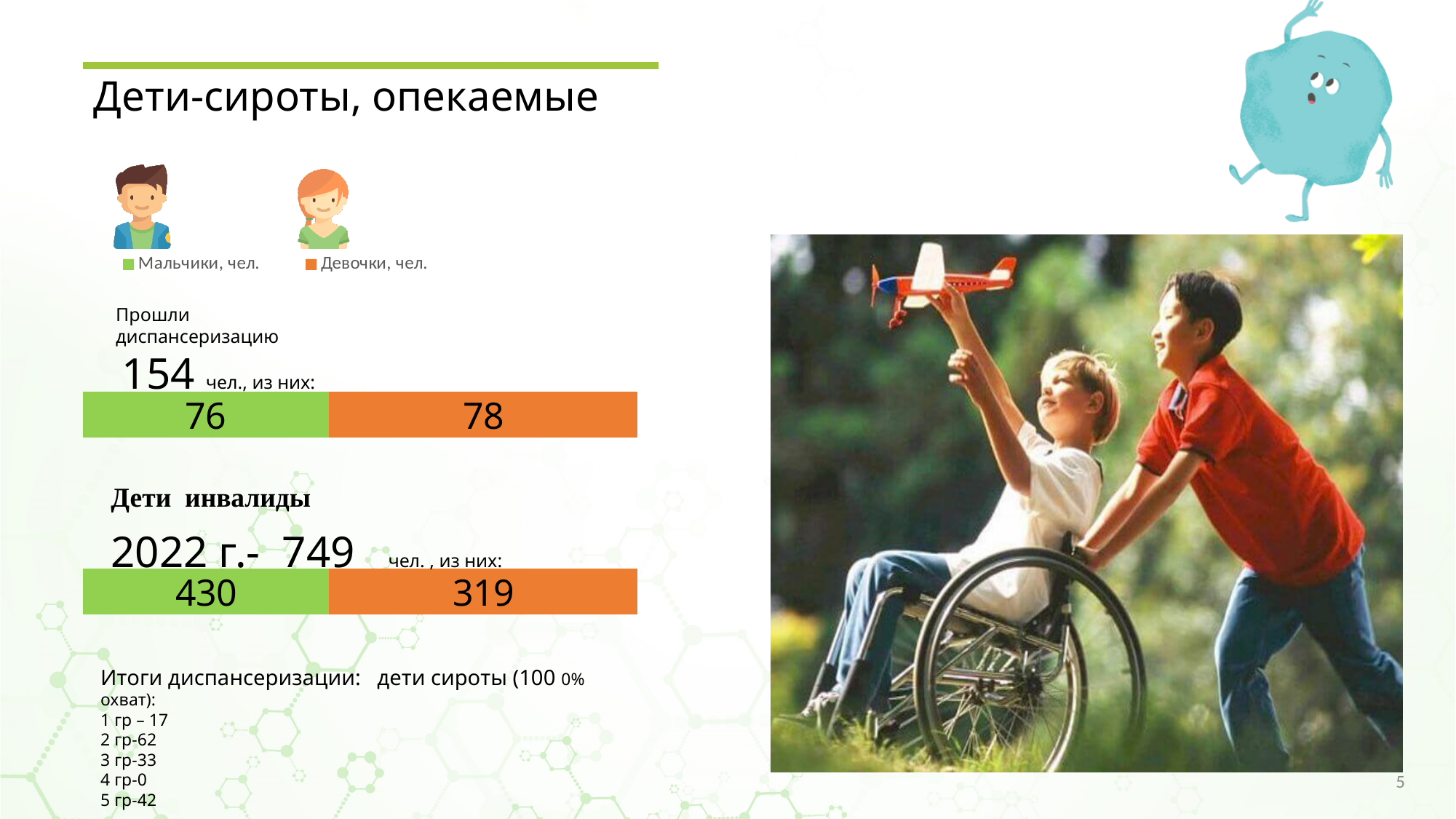
In the top chart (Прошли диспансеризацию), what is the difference between the values for Девочки and Мальчики? 2 Which colour represents Девочки in the charts? Orange In the bottom chart (Дети инвалиды, 2022 г.), what is the value for Девочки? 319 What kind of chart is used to show the Мальчики and Девочки values on the slide? Stacked bar chart How many series does the legend list for the charts on the slide? 2 In the bottom chart (Дети инвалиды), what is the difference between the values for Мальчики and Девочки? 111 In the bottom chart (Дети инвалиды, 2022 г.), what is the value for Мальчики? 430 In the top chart (Прошли диспансеризацию), what is the value for Мальчики? 76 What is the total of the stacked bar in the bottom chart (Дети инвалиды, 2022 г.)? 749 What is the total of the stacked bar in the top chart (Прошли диспансеризацию)? 154 In the top chart (Прошли диспансеризацию), what is the value for Девочки? 78 In the bottom chart (Дети инвалиды), which series has the larger value, Мальчики or Девочки? Мальчики